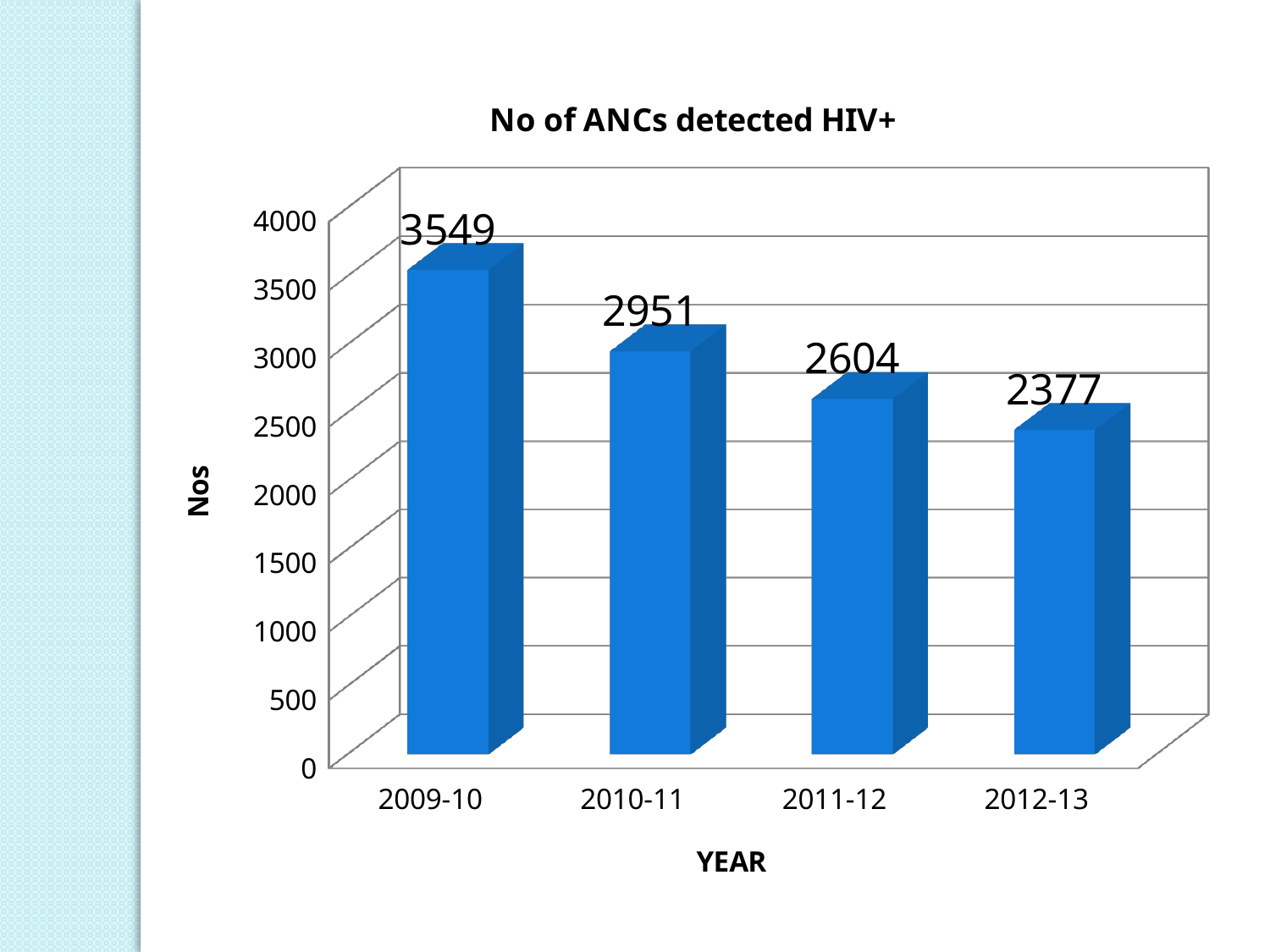
What is the difference between the values for 2009-10 and 2010-11? 598 Which year has the lowest number of ANCs detected HIV+? 2012-13 What is the number of ANCs detected HIV+ in 2012-13? 2377 What is the difference between the values for 2011-12 and 2012-13? 227 How many years are shown on the x axis? 4 What value is shown for 2011-12? 2604 Which is larger, the value for 2010-11 or the value for 2011-12? 2010-11 What kind of chart is shown on the slide? bar chart Is the value for 2010-11 greater or less than 3000? less What is the number of ANCs detected HIV+ in 2009-10? 3549 Do the values rise or fall from 2009-10 to 2012-13? fall Which year has the highest number of ANCs detected HIV+? 2009-10